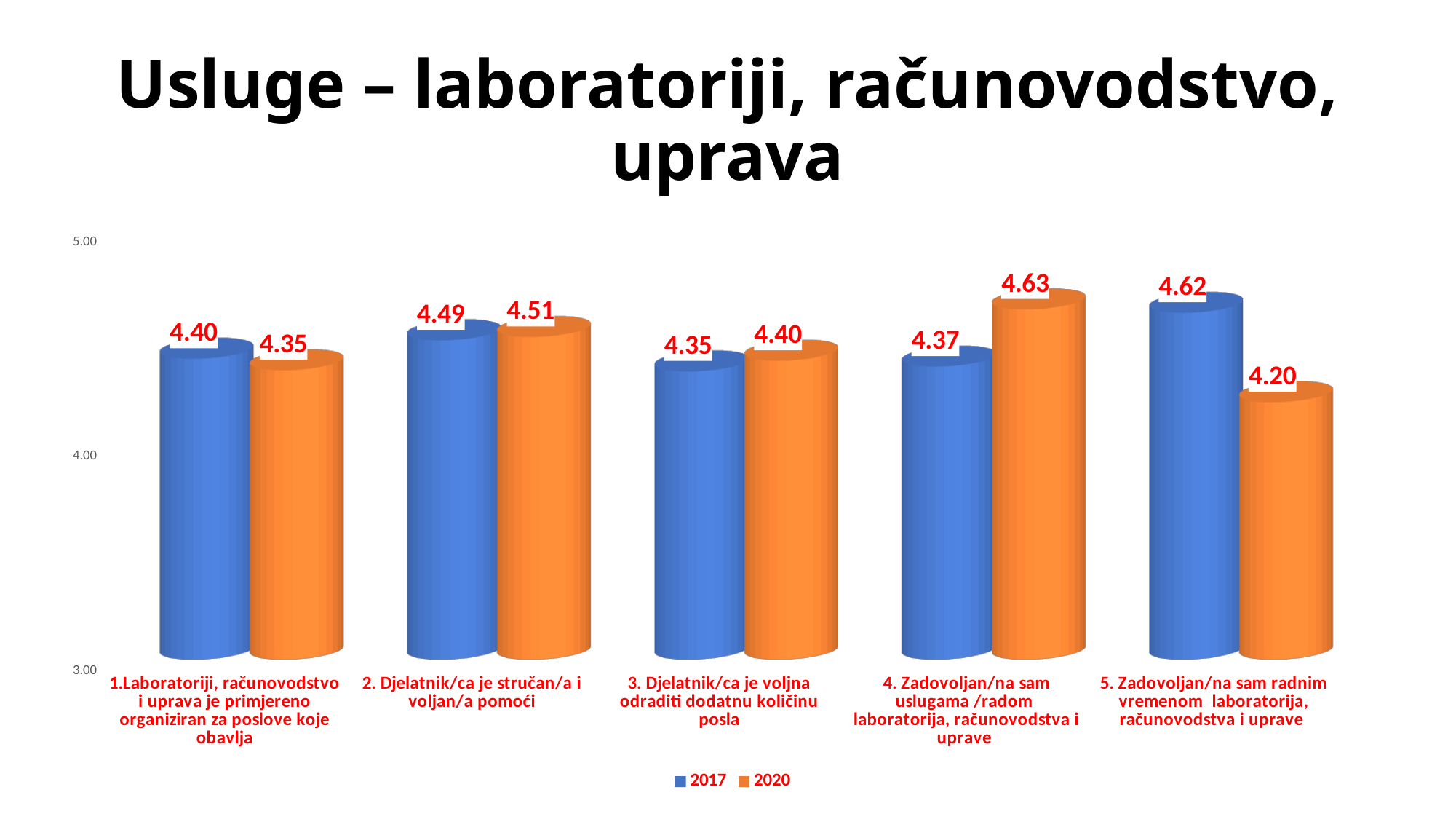
What is the 2020 value for category 5 (Zadovoljan/na sam radnim vremenom laboratorija, računovodstva i uprave)? 4.20 How many series does the legend list? 2 What kind of chart is shown on the slide? Bar chart What is the 2017 value for category 1 (Laboratoriji, računovodstvo i uprava je primjereno organiziran za poslove koje obavlja)? 4.40 How many categories are shown on the x axis? 5 For category 3 (Djelatnik/ca je voljna odraditi dodatnu količinu posla), which year has the larger value, 2017 or 2020? 2020 What is the difference between the 2017 and 2020 values for category 5 (Zadovoljan/na sam radnim vremenom)? 0.42 What is the difference between the 2020 and 2017 values for category 4 (Zadovoljan/na sam uslugama /radom)? 0.26 Which category has the lowest 2020 value? 5. Zadovoljan/na sam radnim vremenom laboratorija, računovodstva i uprave What is the 2020 value for category 4 (Zadovoljan/na sam uslugama /radom laboratorija, računovodstva i uprave)? 4.63 Which category has the highest 2017 value? 5. Zadovoljan/na sam radnim vremenom laboratorija, računovodstva i uprave Which category has the lowest 2017 value? 3. Djelatnik/ca je voljna odraditi dodatnu količinu posla